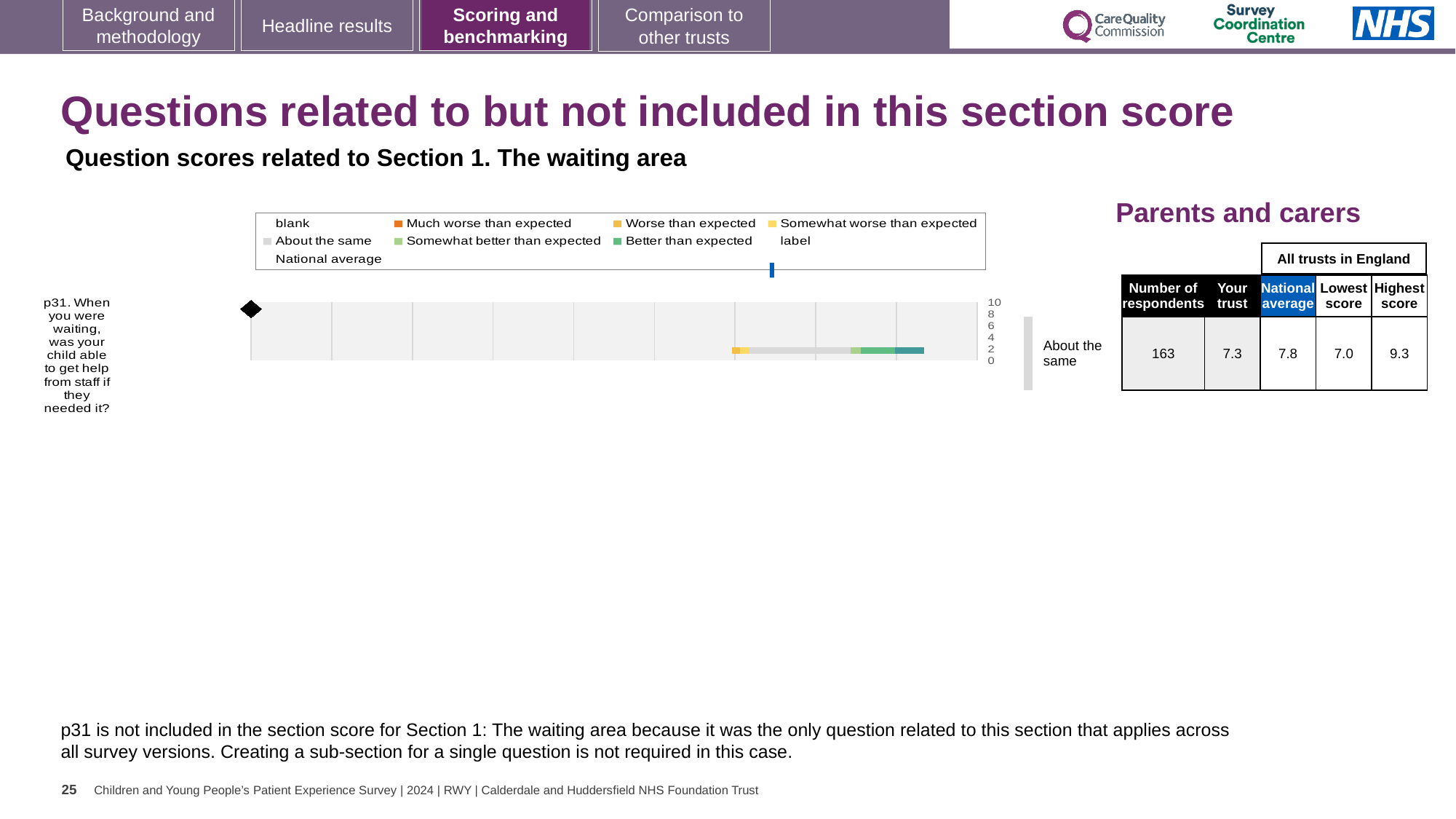
Which question number is plotted in the chart? p31 What is the 'Your trust' score for p31 in the table beside the chart? 7.3 Which is larger for p31, the 'Your trust' score or the national average? National average How many respondents answered p31? 163 What benchmark category label is shown next to the p31 bar? About the same What is the difference between the highest score and the lowest score for p31? 2.3 How many survey questions are plotted in the chart? 1 What is the highest score across all trusts in England for p31? 9.3 What kind of chart is used to show the p31 result? bar chart What is the lowest score across all trusts in England for p31? 7.0 How many entries does the chart legend list? 9 What is the national average score for p31 in the table beside the chart? 7.8